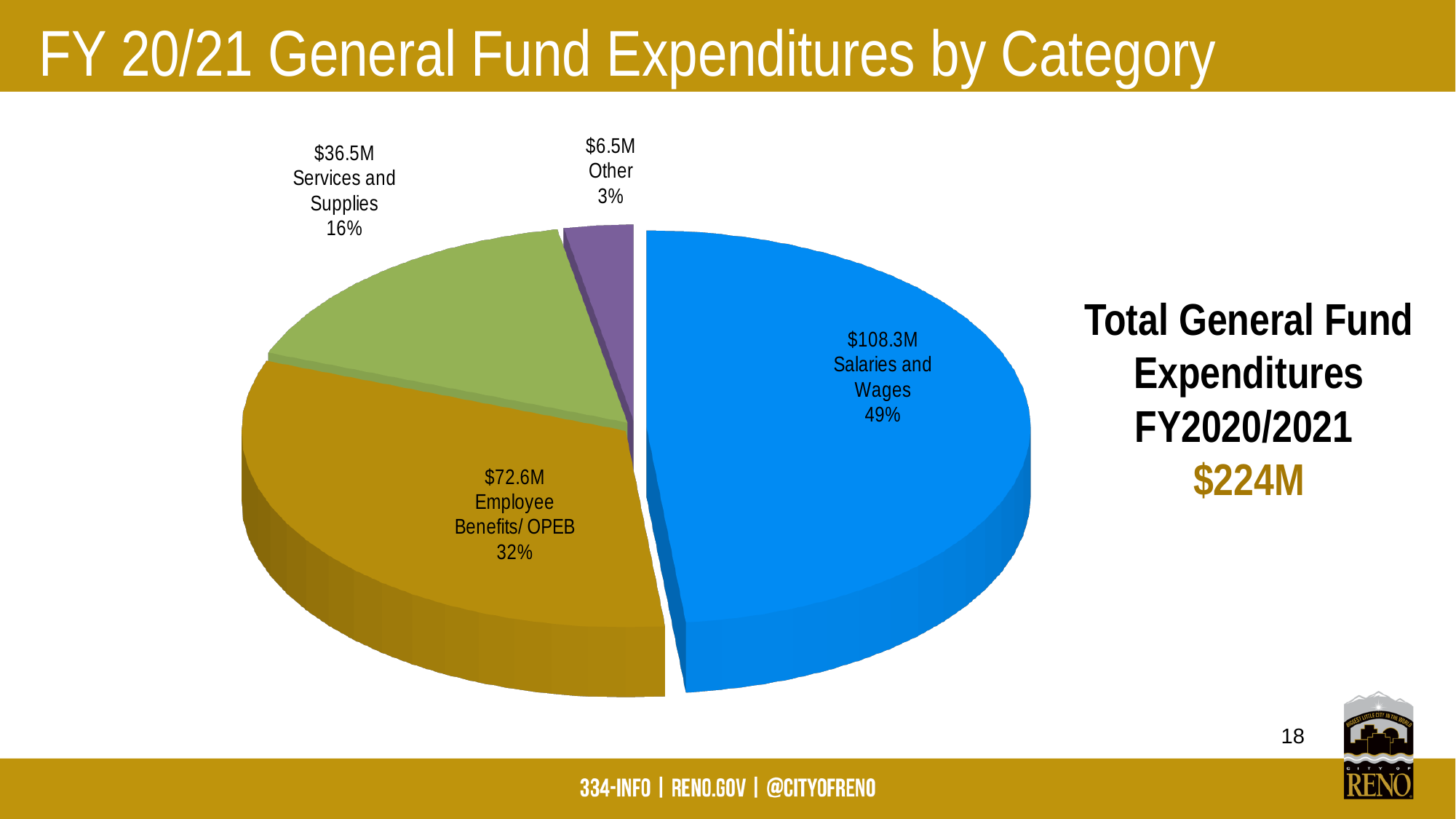
What is the value for Other? $6.5M What share of the pie does Services and Supplies represent? 16% Which category has the smallest share of the pie? Other Which category has the largest share of the pie? Salaries and Wages What type of chart is shown on the slide? Pie chart What is the value for Services and Supplies? $36.5M How many categories does the pie chart show? 4 What share of the pie does Employee Benefits/ OPEB represent? 32% What is the difference between Salaries and Wages and Employee Benefits/ OPEB? $35.7M Which is larger, Services and Supplies or Employee Benefits/ OPEB? Employee Benefits/ OPEB What is the value for Employee Benefits/ OPEB? $72.6M What is the value for Salaries and Wages? $108.3M